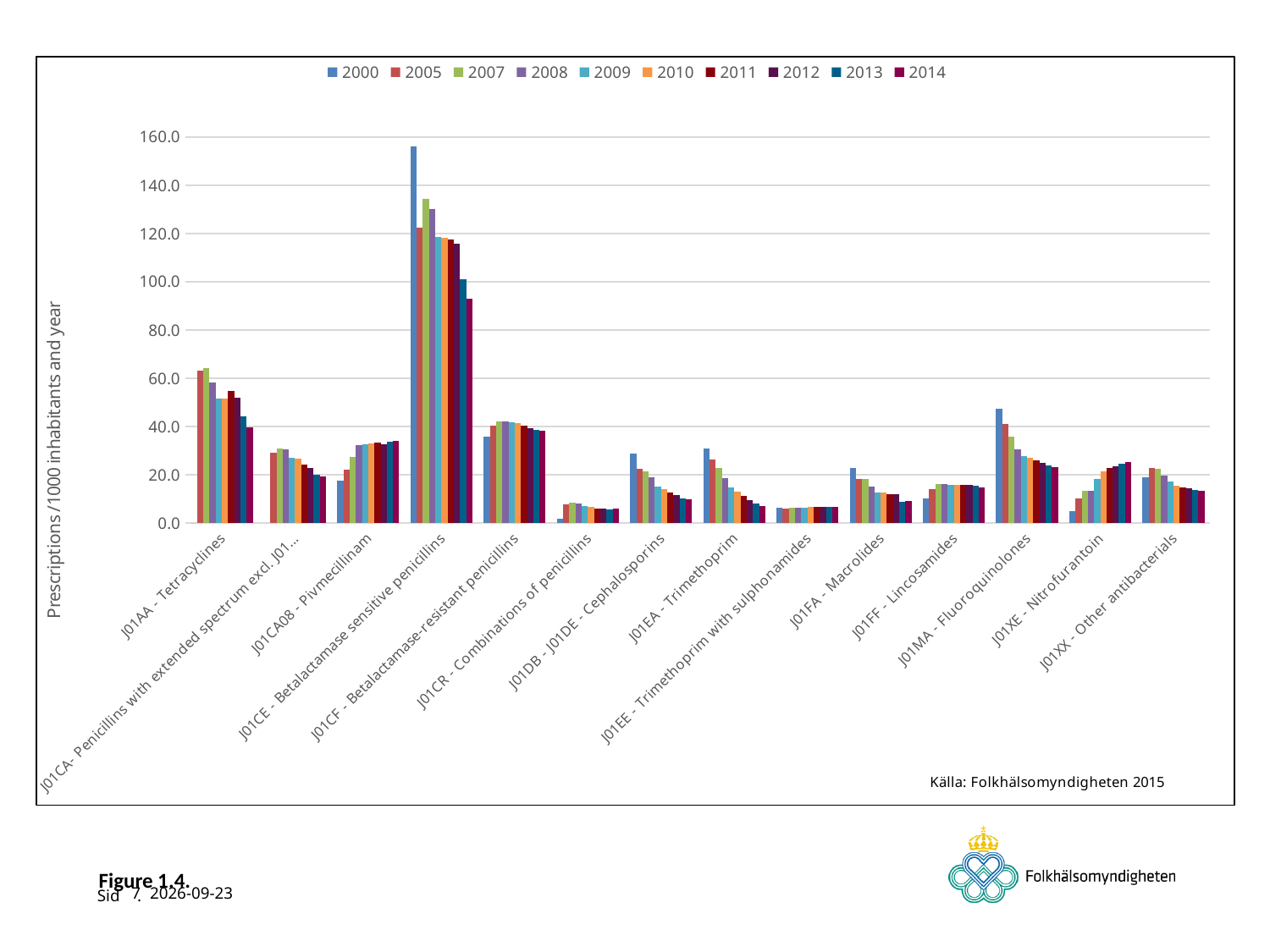
How many antibiotic categories are shown along the x axis? 14 Is the 2014 value for J01CE - Betalactamase sensitive penicillins greater or less than 100.0? less What is the label of the y axis? Prescriptions/1000 inhabitants and year What kind of chart is shown on the slide? bar chart Do the values for J01CE - Betalactamase sensitive penicillins rise or fall from 2000 to 2014? fall Do the values for J01XE - Nitrofurantoin rise or fall from 2000 to 2014? rise Is the 2000 value for J01XE - Nitrofurantoin greater or less than 10.0? less Which category has the highest prescription rate in the chart? J01CE - Betalactamase sensitive penicillins How many series (years) does the legend list? 10 Is the 2000 value for J01MA - Fluoroquinolones greater or less than 40.0? greater